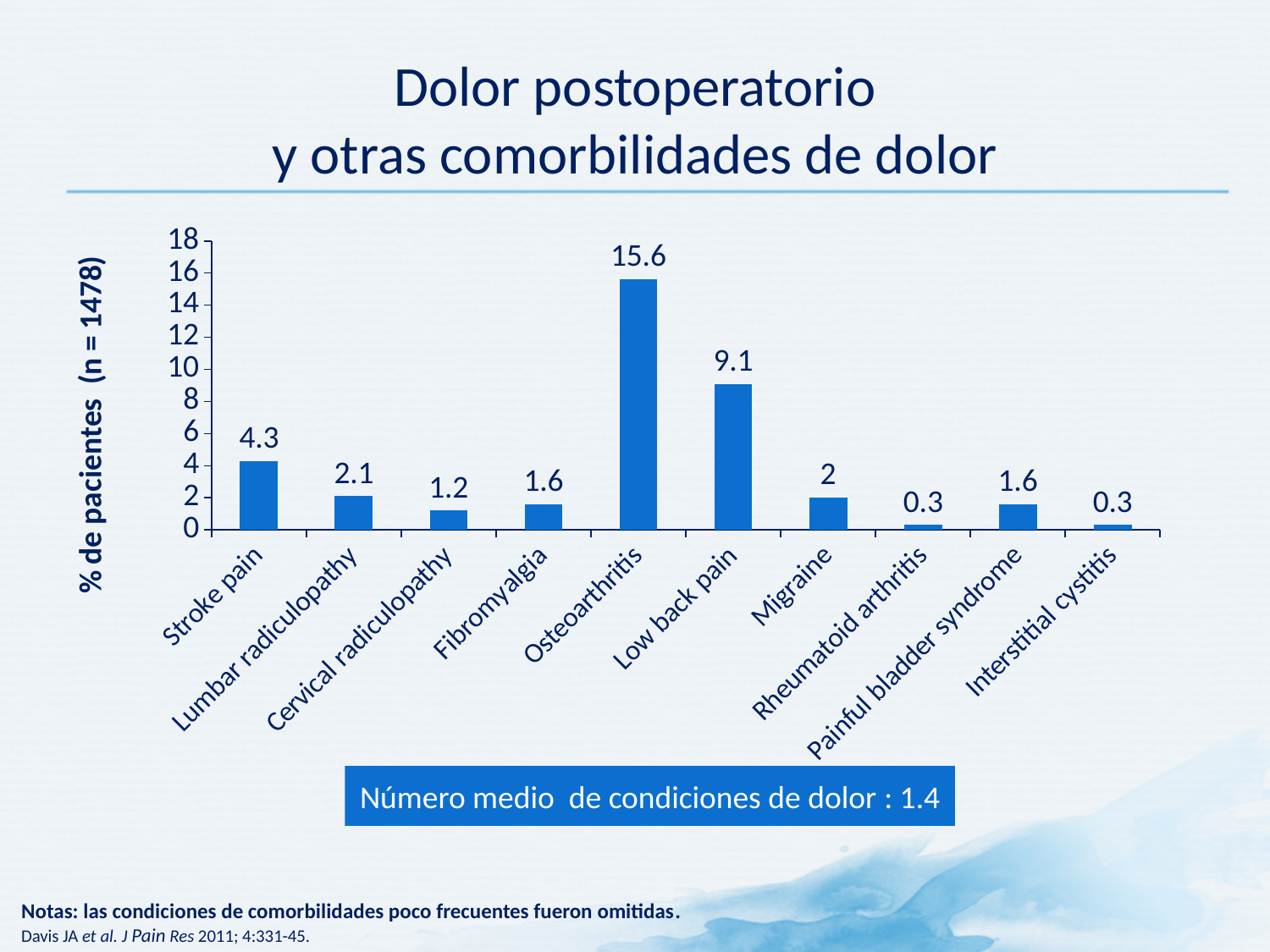
What kind of chart is shown on the slide? Bar chart Is the value for Osteoarthritis greater or less than 14? greater Which category has the highest value? Osteoarthritis What is the value for Painful bladder syndrome? 1.6 How many categories are shown on the x axis? 10 What is the value for Low back pain? 9.1 Which is larger, the value for Lumbar radiculopathy or the value for Migraine? Lumbar radiculopathy What is the difference between the values for Stroke pain and Cervical radiculopathy? 3.1 What is the label of the y axis? % de pacientes (n = 1478) What is the difference between the values for Osteoarthritis and Low back pain? 6.5 What is the value for Stroke pain? 4.3 What is the value for Osteoarthritis? 15.6